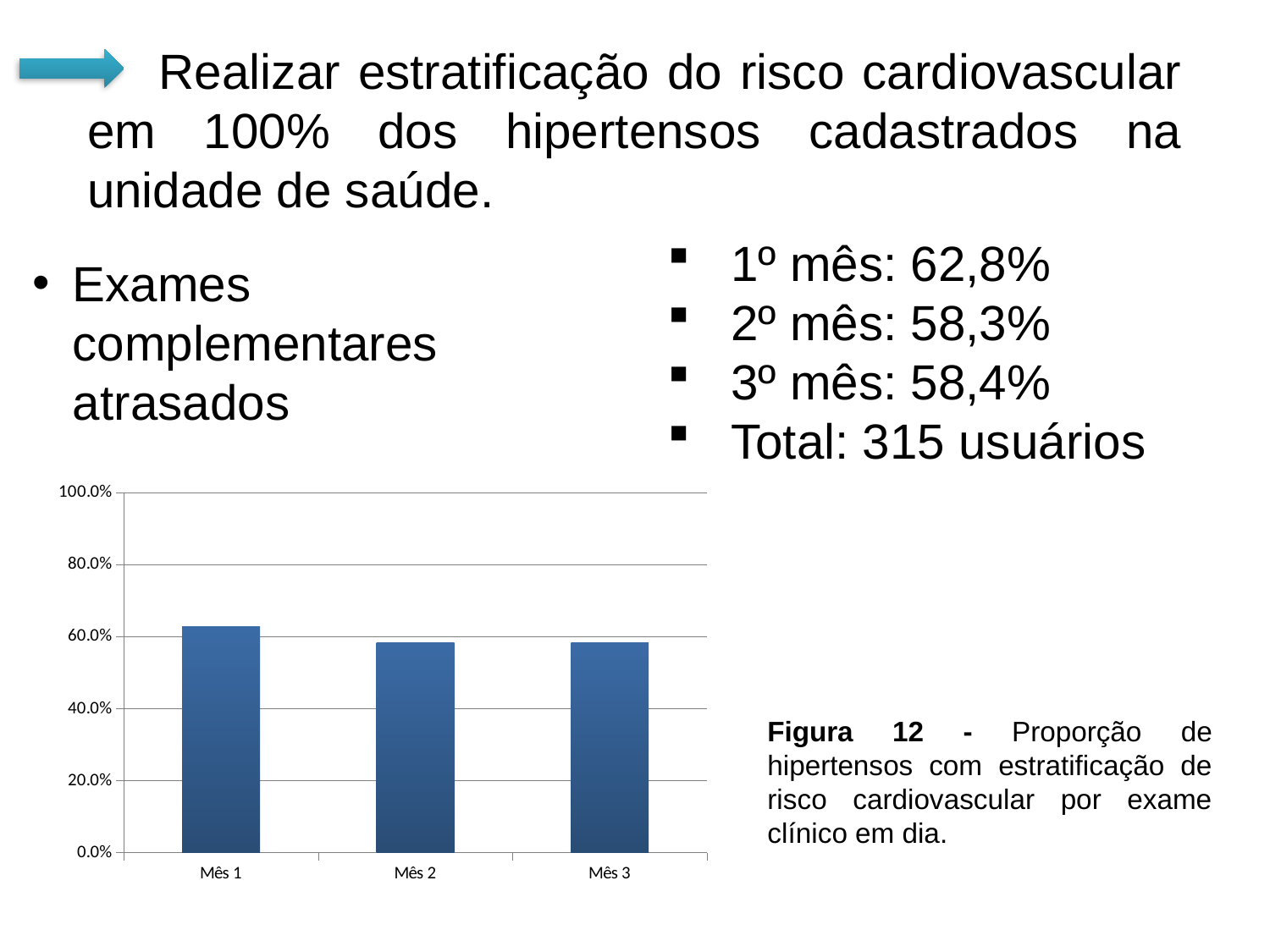
According to the text on the slide, what is the proportion for the 2º mês? 58,3% Does the value rise or fall from Mês 1 to Mês 2? fall What figure number is given in the caption next to the chart? Figura 12 Is the value for Mês 3 greater or less than 40.0%? greater According to the text on the slide, what is the proportion for the 1º mês? 62,8% What kind of chart is shown on the slide? bar chart Is the value for Mês 2 greater or less than 60.0%? less Which is larger, the value for Mês 3 or the value for Mês 1? Mês 1 Which month has the highest bar in the chart? Mês 1 How many bars (months) are plotted in the chart? 3 Which is larger, the value for Mês 1 or the value for Mês 2? Mês 1 Is the value for Mês 1 greater or less than 60.0%? greater